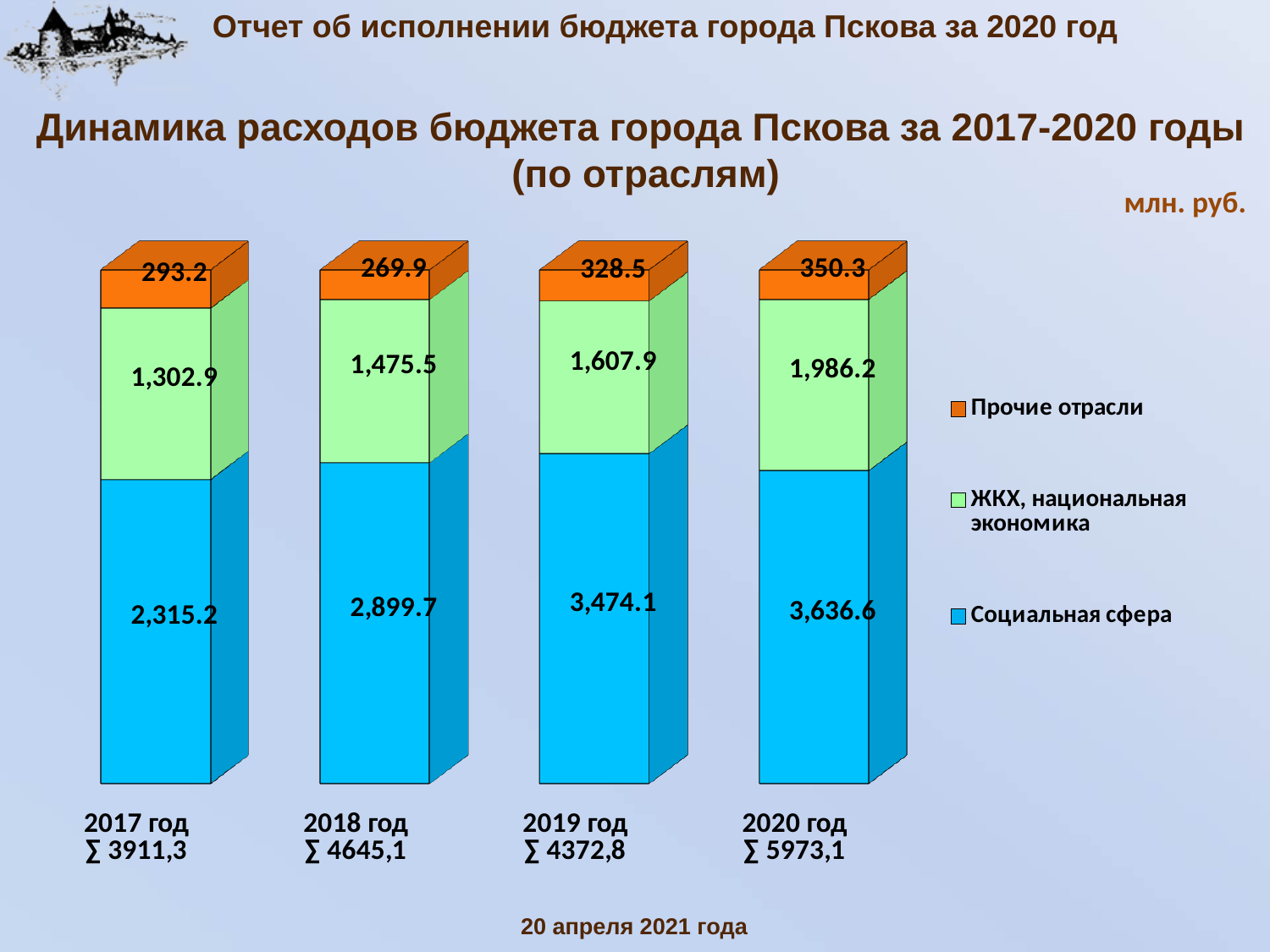
What is the value for Прочие отрасли in 2019 год? 328.5 Which is larger: the ЖКХ, национальная экономика value in 2017 год or in 2019 год? 2019 год What is the value for Социальная сфера in 2020 год? 3,636.6 How many series does the legend list? 3 What is the difference between the Социальная сфера values for 2019 год and 2018 год? 574.4 Does the ЖКХ, национальная экономика value rise or fall from 2017 год to 2020 год? Rise What is the value for ЖКХ, национальная экономика in 2018 год? 1,475.5 How many years are shown on the x axis? 4 In which year is the Социальная сфера value the highest? 2020 год What kind of chart is shown on the slide? Stacked bar chart What is the total of the stacked bar for 2020 год? 5973,1 In which year is the Прочие отрасли value the lowest? 2018 год